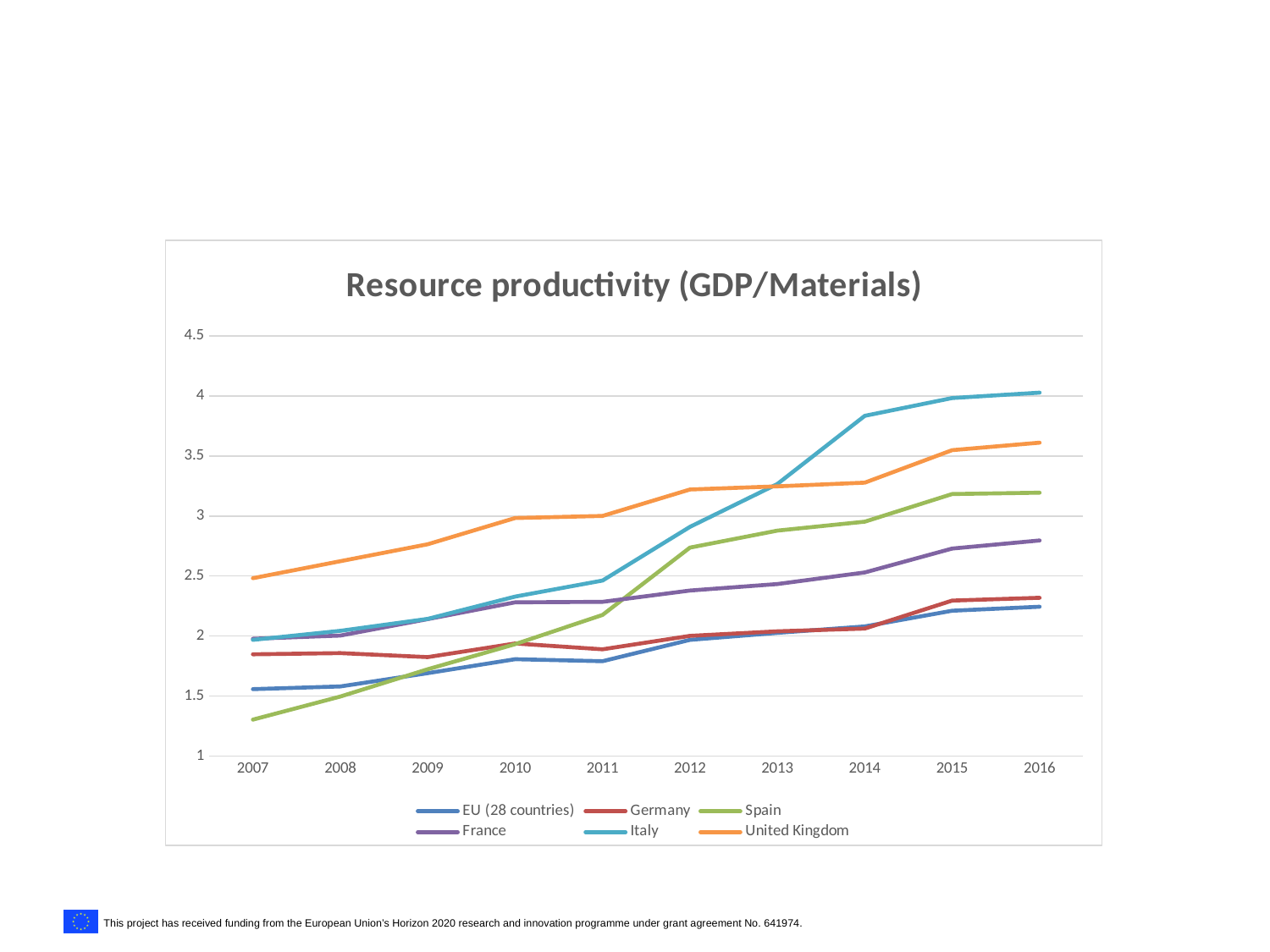
How many years are shown on the x axis? 10 What kind of chart is shown on the slide? line chart Which series has the highest value in 2007? United Kingdom Is the value for Spain in 2007 greater or less than 1.5? less What is the title of the chart? Resource productivity (GDP/Materials) Which series has the lowest value in 2007? Spain Does the value for Italy rise or fall from 2007 to 2016? rise In 2007, which is larger: the value for Germany or the value for Spain? Germany Is the value for Italy in 2014 greater or less than 3.5? greater Which series has the highest value in 2016? Italy In 2016, which is larger: the value for Spain or the value for France? Spain How many series does the legend list? 6